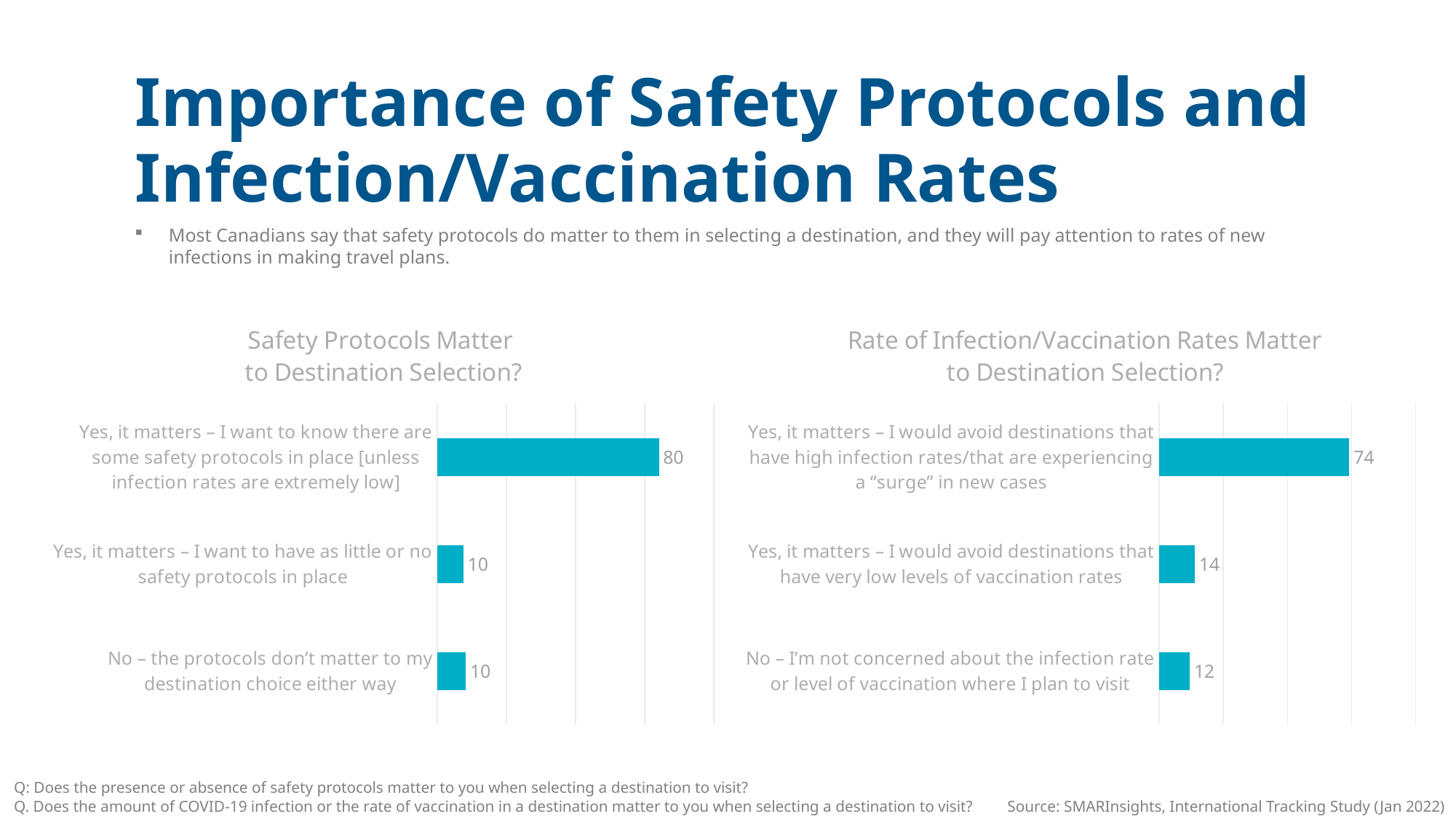
In the 'Rate of Infection/Vaccination Rates Matter to Destination Selection?' chart, what is the value for 'No – I'm not concerned about the infection rate or level of vaccination where I plan to visit'? 12 In the 'Safety Protocols Matter to Destination Selection?' chart, what is the difference between the value for wanting some safety protocols in place and the value for wanting as little or no safety protocols? 70 In the 'Rate of Infection/Vaccination Rates Matter to Destination Selection?' chart, which category has the lowest value? No – I'm not concerned about the infection rate or level of vaccination where I plan to visit Which is larger: the top bar in the 'Safety Protocols Matter' chart or the top bar in the 'Rate of Infection/Vaccination Rates Matter' chart? The top bar in the 'Safety Protocols Matter' chart (80) What type of chart is the 'Rate of Infection/Vaccination Rates Matter to Destination Selection?' chart? Bar chart In the 'Rate of Infection/Vaccination Rates Matter to Destination Selection?' chart, what is the difference between the highest value and the value for avoiding destinations with very low vaccination rates? 60 In the 'Rate of Infection/Vaccination Rates Matter to Destination Selection?' chart, what is the value for 'Yes, it matters – I would avoid destinations that have very low levels of vaccination rates'? 14 In the 'Safety Protocols Matter to Destination Selection?' chart, what is the value for 'No – the protocols don't matter to my destination choice either way'? 10 In the 'Safety Protocols Matter to Destination Selection?' chart, what is the value for 'Yes, it matters – I want to know there are some safety protocols in place'? 80 What is the source cited at the bottom of the slide? SMARInsights, International Tracking Study (Jan 2022) In the 'Rate of Infection/Vaccination Rates Matter to Destination Selection?' chart, which category has the highest value? Yes, it matters – I would avoid destinations that have high infection rates/that are experiencing a "surge" in new cases How many categories are shown in the 'Safety Protocols Matter to Destination Selection?' chart? 3